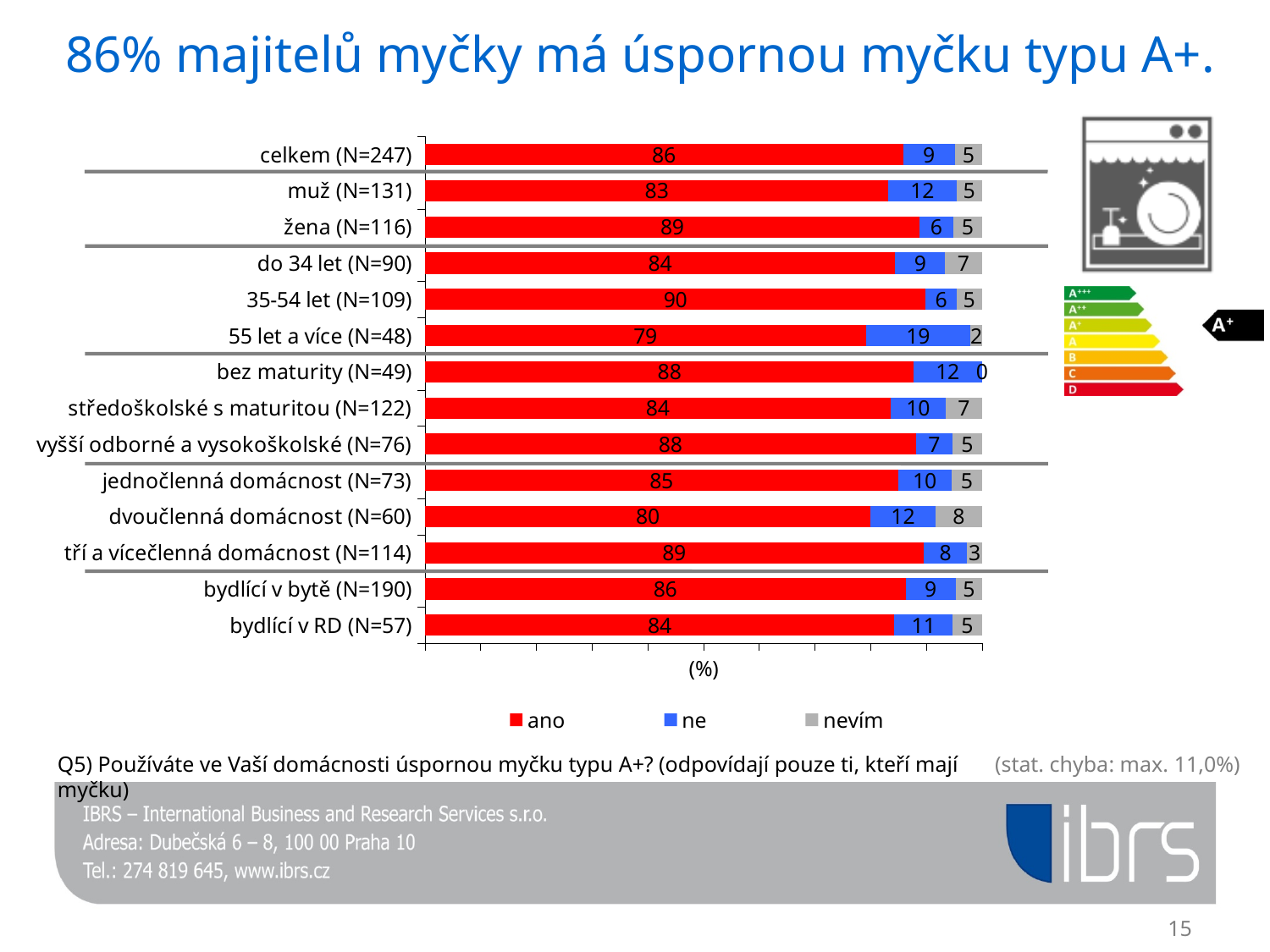
What is the "ne" value for "55 let a více (N=48)"? 19 How many series does the legend list? 3 What is the "ano" value for "celkem (N=247)"? 86 What kind of chart is shown on the slide? stacked bar chart Which colour represents the "ne" series in the chart? blue How many categories are shown on the chart? 14 Which has a larger "ne" value: "bez maturity (N=49)" or "vyšší odborné a vysokoškolské (N=76)"? bez maturity (N=49) What is the total of the stacked bar for "bydlící v RD (N=57)"? 100 Which category has the lowest "ano" value? 55 let a více (N=48) What is the difference between the "ano" values for "žena (N=116)" and "muž (N=131)"? 6 Which category has the highest "ano" value? 35-54 let (N=109) What is the "nevím" value for "dvoučlenná domácnost (N=60)"? 8